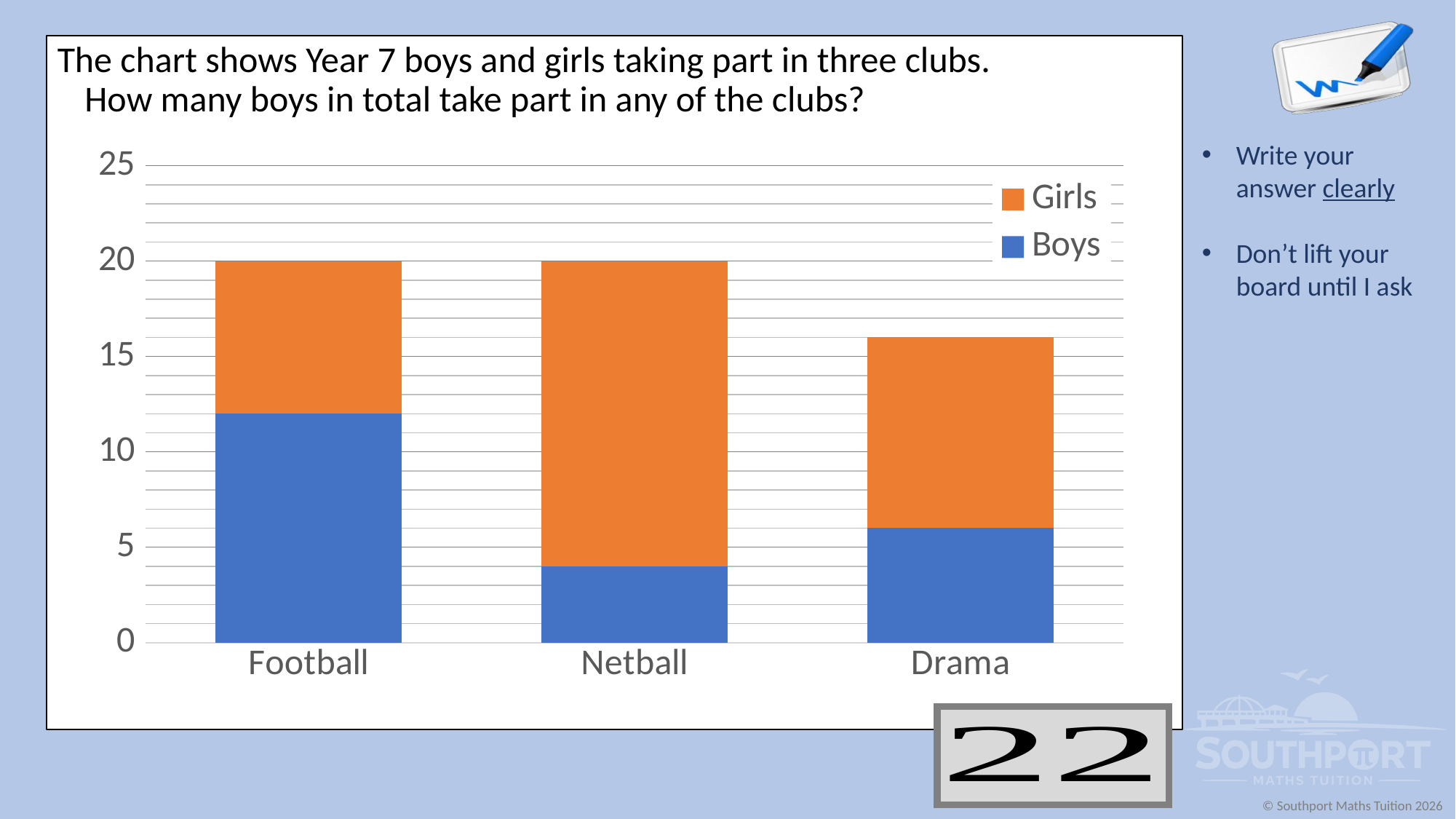
How many clubs are shown on the x axis of the chart? 3 How many series does the chart's legend list? 2 What is the total height of the stacked bar for Football? 20 Which is larger, the Girls segment for Netball or the Girls segment for Football? Netball Is the Boys value for Netball greater or less than 5? less Which club has the largest Boys segment? Football What are the two entries in the chart's legend? Girls and Boys Which club has the smallest Boys segment? Netball What kind of chart is shown on the slide? bar chart Is the Boys value for Football greater or less than 10? greater Is the total height of the Drama bar greater or less than 15? greater What is the total height of the stacked bar for Netball? 20